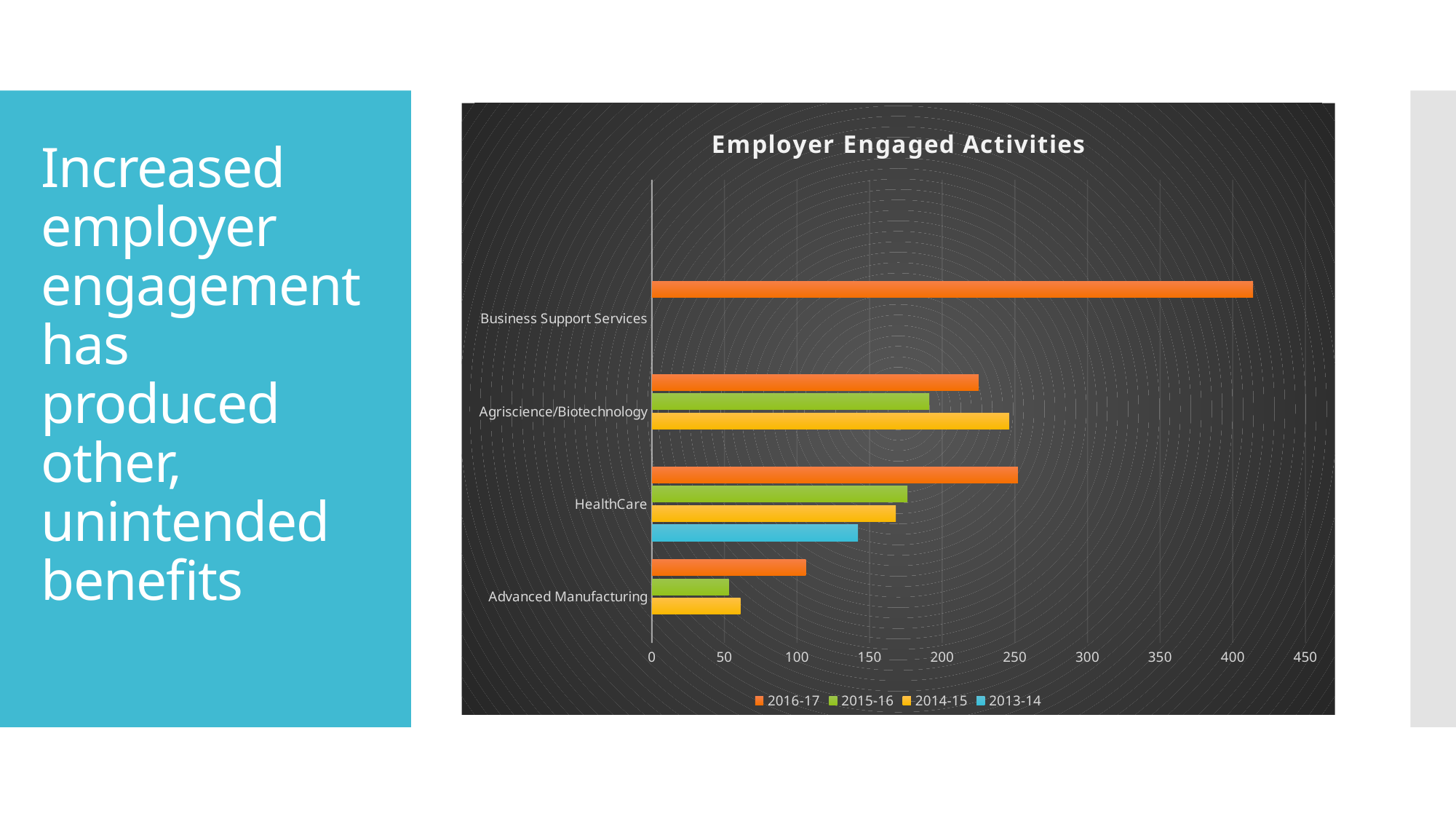
What is the title of the chart? Employer Engaged Activities What kind of chart is shown on the slide? bar chart How many series does the legend list? 4 Is the 2015-16 value for Advanced Manufacturing greater or less than 100? less Is the 2014-15 value for Agriscience/Biotechnology greater or less than 200? greater Which category has the lowest value for 2016-17? Advanced Manufacturing Which category is the only one with a 2013-14 bar? HealthCare Is the 2016-17 value for Business Support Services greater or less than 350? greater Which category has the highest value for 2016-17? Business Support Services Which is larger for 2016-17: HealthCare or Agriscience/Biotechnology? HealthCare How many categories are shown on the chart? 4